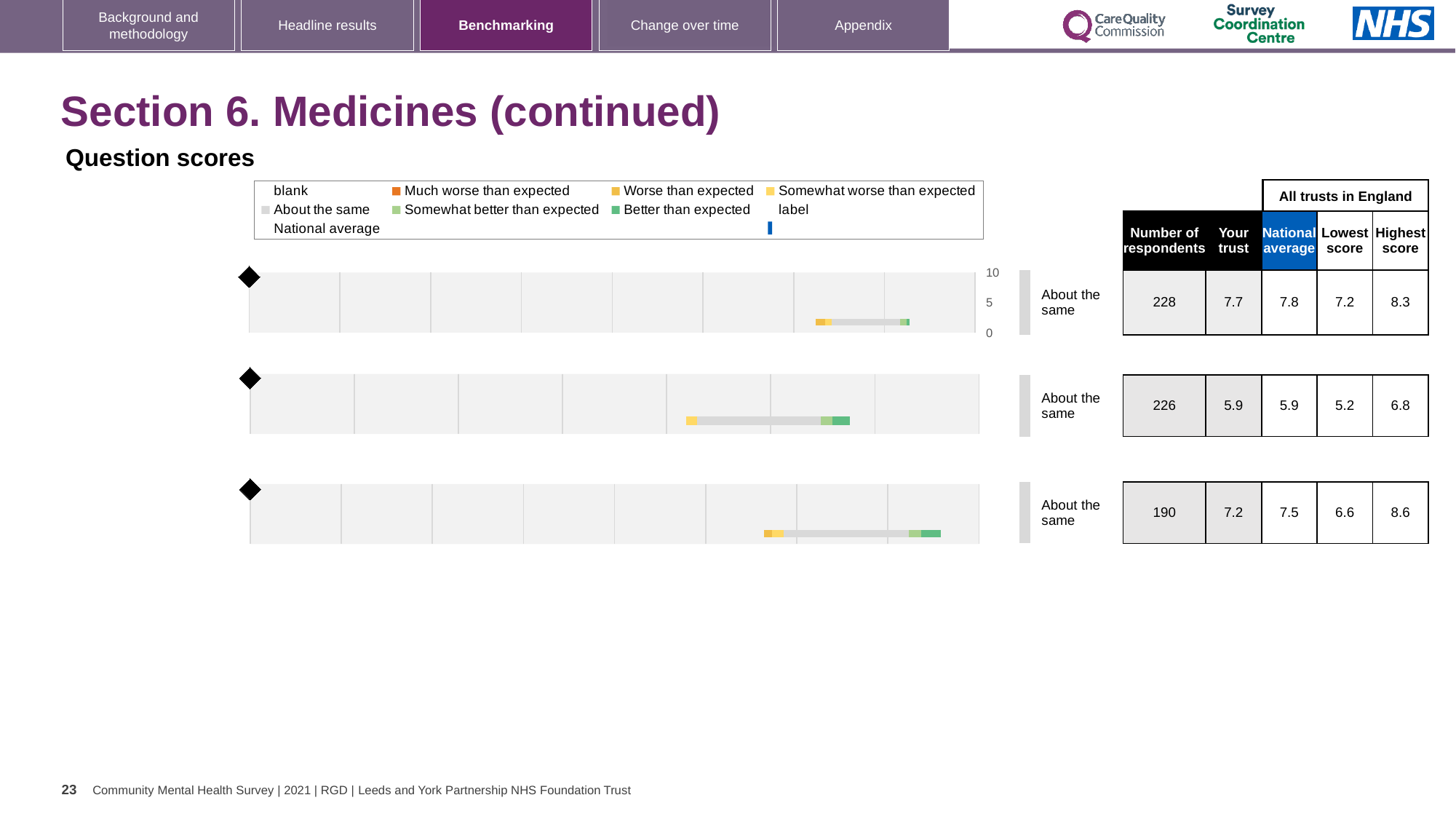
What is the highest value shown on the vertical axis of the top chart? 10 What benchmark category label is shown to the right of the top chart? About the same In the table beside the middle chart, what is the number of respondents? 226 In the table beside the bottom chart, is the 'Your trust' score larger or smaller than the national average? smaller Which legend entry is shown in orange? Much worse than expected What kind of chart is used for the question scores on this slide? bar chart In the table beside the top chart, what is the difference between the highest score and the lowest score? 1.1 How many benchmarking charts are shown on the slide? 3 In the table beside the bottom chart, what is the highest score across all trusts in England? 8.6 In the table beside the top chart, what is the 'Your trust' score? 7.7